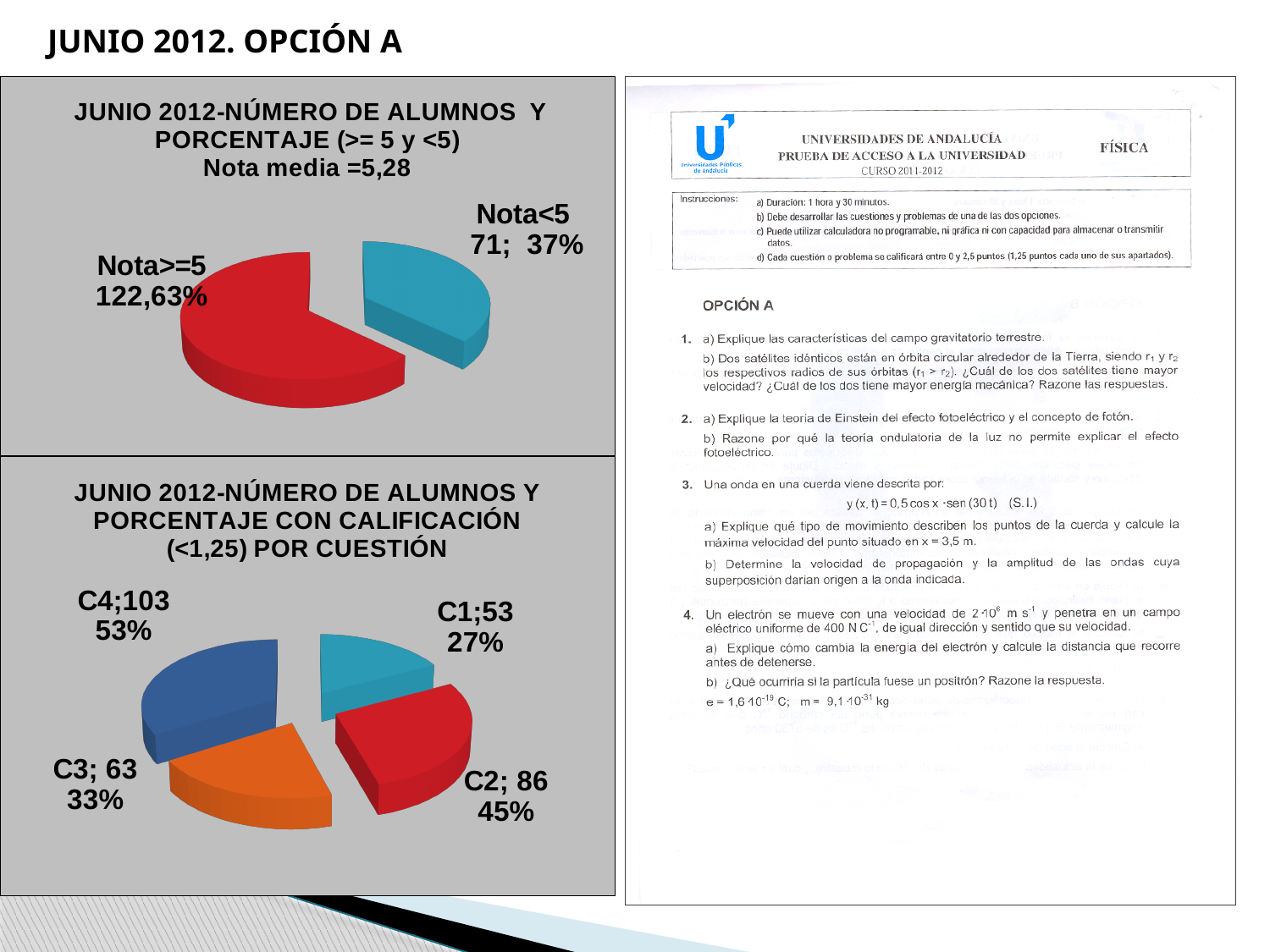
In the top chart (>= 5 y <5), which slice is larger, Nota>=5 or Nota<5? Nota>=5 In the bottom chart (CALIFICACIÓN (<1,25) POR CUESTIÓN), what percentage is shown for C2? 45% In the bottom chart (CALIFICACIÓN (<1,25) POR CUESTIÓN), what is the difference in number of students between C4 and C1? 50 What kind of chart is the top chart on the left (JUNIO 2012-NÚMERO DE ALUMNOS Y PORCENTAJE (>= 5 y <5))? pie chart In the bottom chart (CALIFICACIÓN (<1,25) POR CUESTIÓN), how many students are shown for C4? 103 In the bottom chart (CALIFICACIÓN (<1,25) POR CUESTIÓN), which cuestión has the lowest number of students? C1 In the bottom chart (CALIFICACIÓN (<1,25) POR CUESTIÓN), how many slices does the pie have? 4 In the top chart (>= 5 y <5), what percentage is shown for the Nota<5 slice? 37% In the top chart (>= 5 y <5), how many slices does the pie have? 2 In the bottom chart (CALIFICACIÓN (<1,25) POR CUESTIÓN), which cuestión has the highest number of students? C4 According to the title of the top chart, what is the Nota media? 5,28 In the top chart (>= 5 y <5), how many students are in the Nota<5 slice? 71